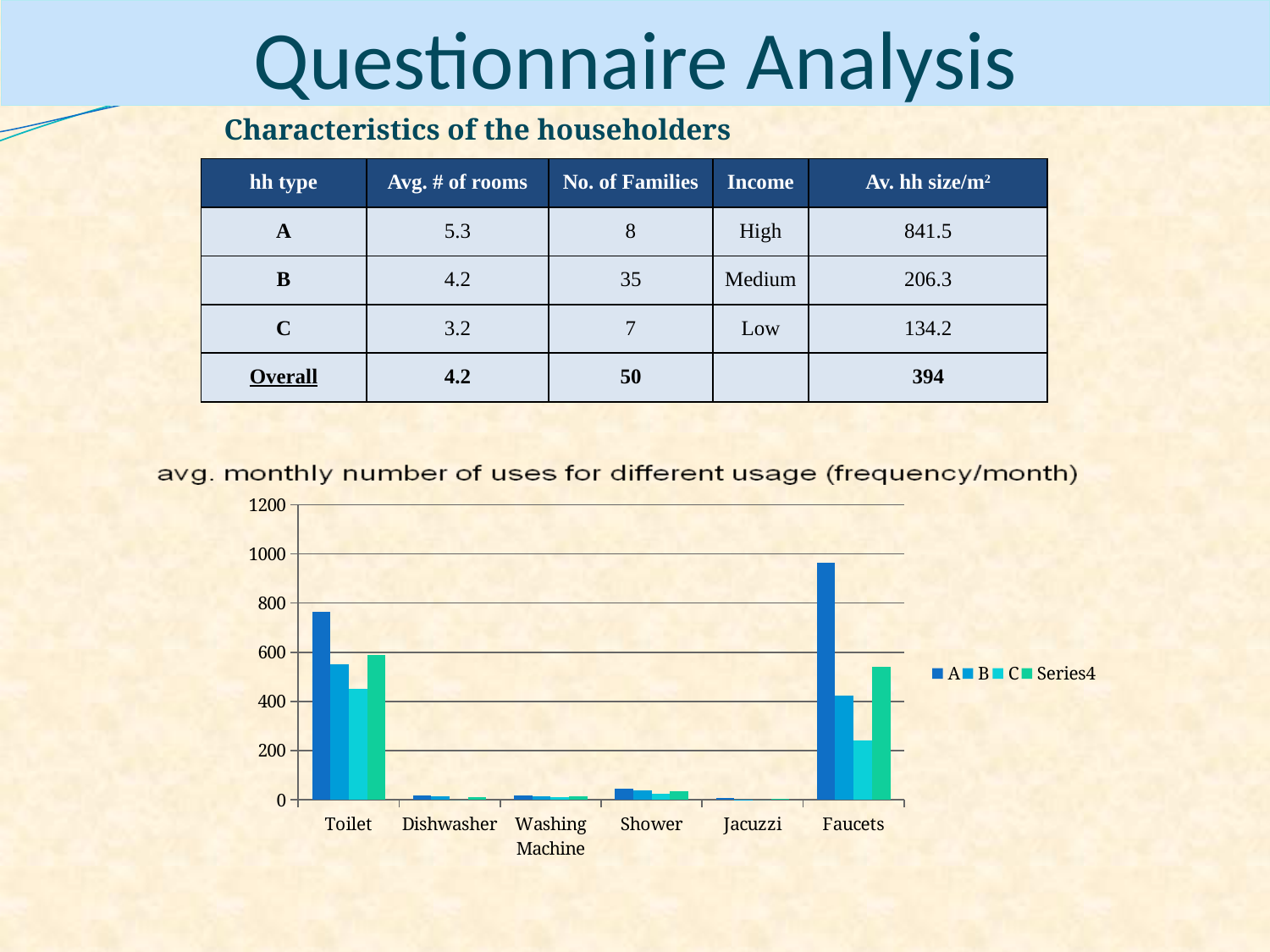
Is the value for series C in the Faucets category greater or less than 400? less What kind of chart is shown on the slide? bar chart Which category has the highest value for series A? Faucets Which is larger: the value for series B in Toilet or the value for series B in Faucets? Toilet Which is larger: the value for series A in Toilet or the value for series A in Faucets? Faucets What is the name of the fourth series in the chart legend? Series4 Which category has the lowest values overall in the chart? Jacuzzi How many categories are shown on the x axis of the chart? 6 Is the value for series A in the Toilet category greater or less than 600? greater Is the value for series A in the Faucets category greater or less than 800? greater How many series does the chart legend list? 4 What is the title of the chart? avg. monthly number of uses for different usage (frequency/month)